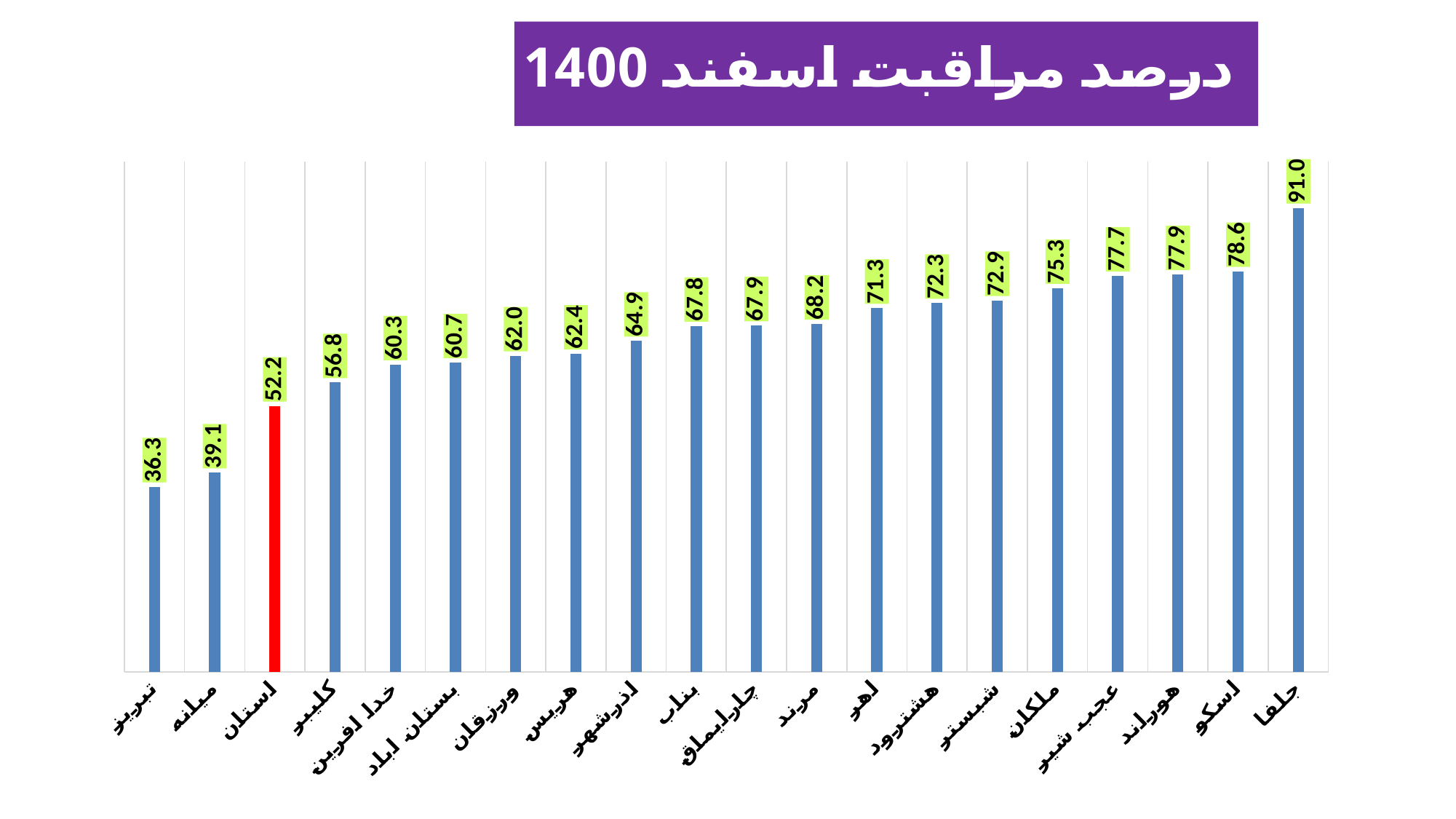
What is the value for جلفا? 91.0 What is the difference between the values for اسکو and استان? 26.4 What is the value for مرند? 68.2 Which category has the lowest value? تبریز What is the title of the chart? درصد مراقبت اسفند 1400 How many categories are shown on the chart? 20 Which category has the highest value? جلفا What is the value for استان (the red bar)? 52.2 Do the values rise or fall from left to right along the x axis? rise What kind of chart is shown on the slide? bar chart Which has a larger value, ملکان or بناب? ملکان What is the difference between the values for جلفا and تبریز? 54.7